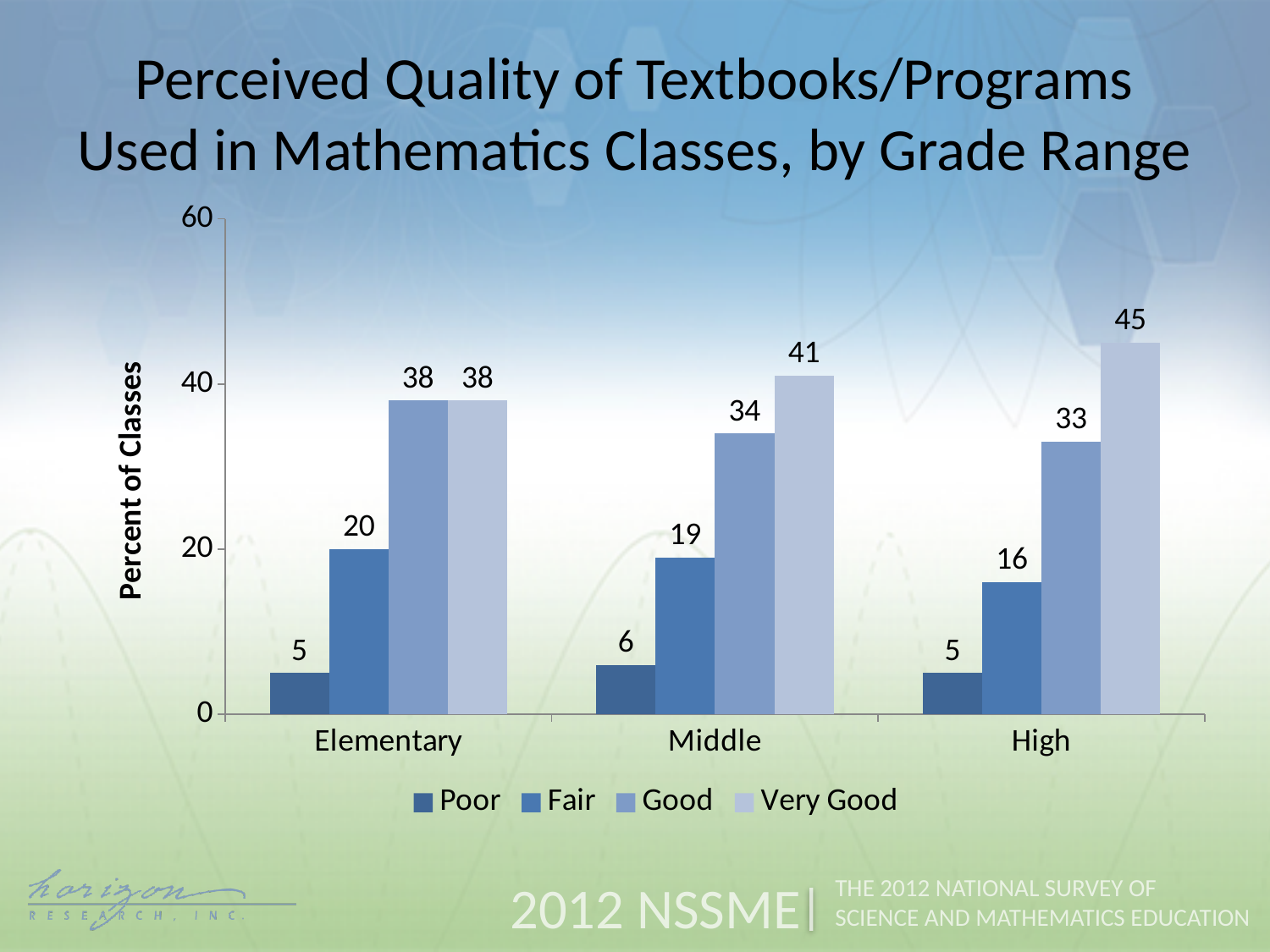
What is the value for Very Good in the High grade range? 45 What percent of Elementary classes rated their textbooks/programs as Fair? 20 Which is larger: the Good value for Elementary or the Good value for High? Elementary Is the Very Good value for Middle greater or less than 40? greater What is the difference between the Very Good values for High and Elementary? 7 What is the value for Good in the Middle grade range? 34 What kind of chart is shown on the slide? Bar chart How many series does the legend list? 4 What is the label of the y axis? Percent of Classes Which grade range has the lowest Fair value? High Which grade range has the highest Very Good value? High How many grade ranges are shown on the x axis? 3